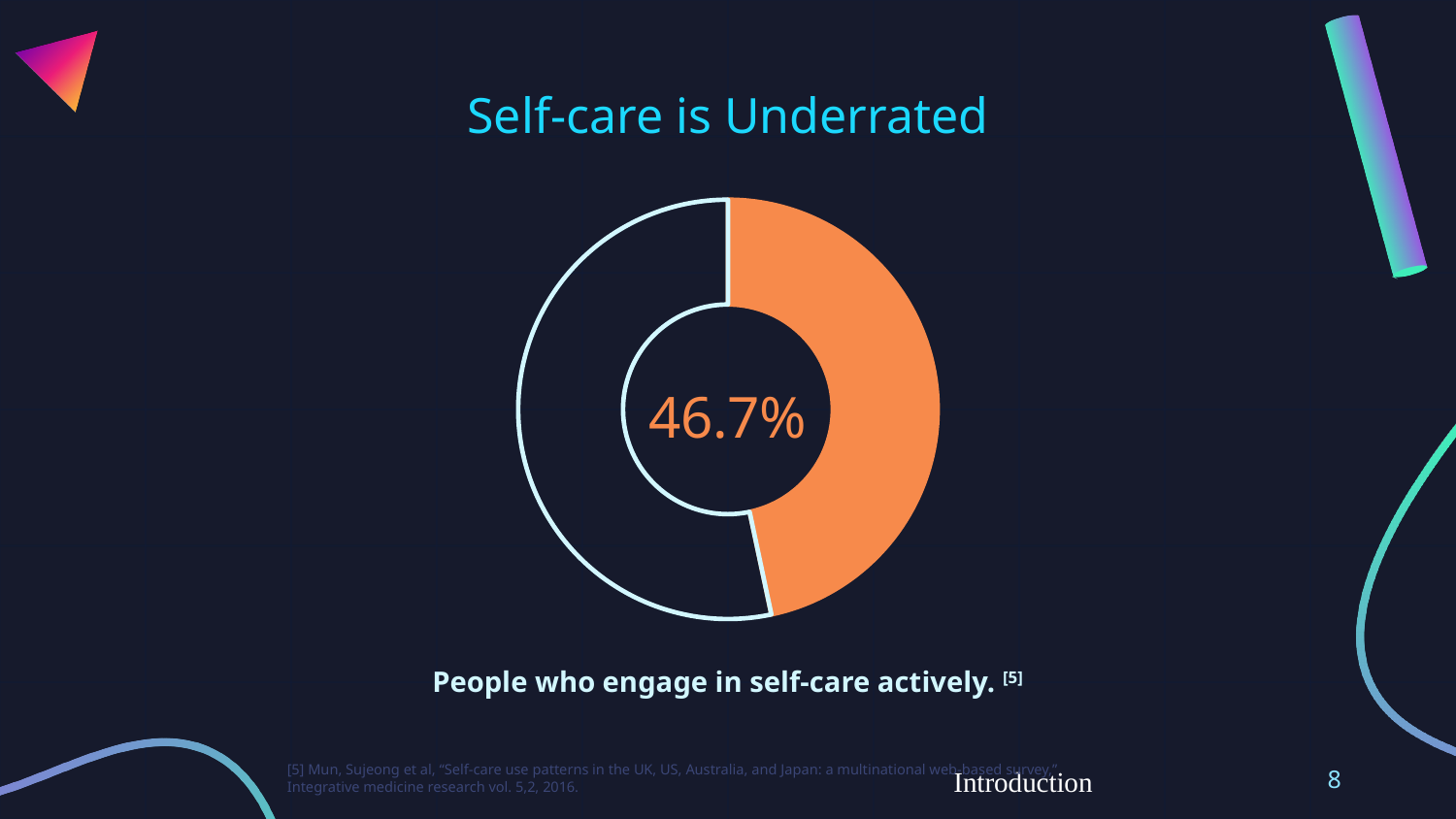
What does the orange slice of the donut chart represent, according to the caption below it? People who engage in self-care actively. What percentage is printed in the centre of the donut chart? 46.7% What kind of chart is shown on the slide? Pie chart (donut) How many slices does the donut chart have? 2 What share of the donut chart does the orange slice represent? 46.7% Which slice of the donut chart is larger, the orange slice or the dark slice? The dark slice Is the orange slice of the donut chart greater or less than half of the chart? less What is the title of the slide containing the donut chart? Self-care is Underrated